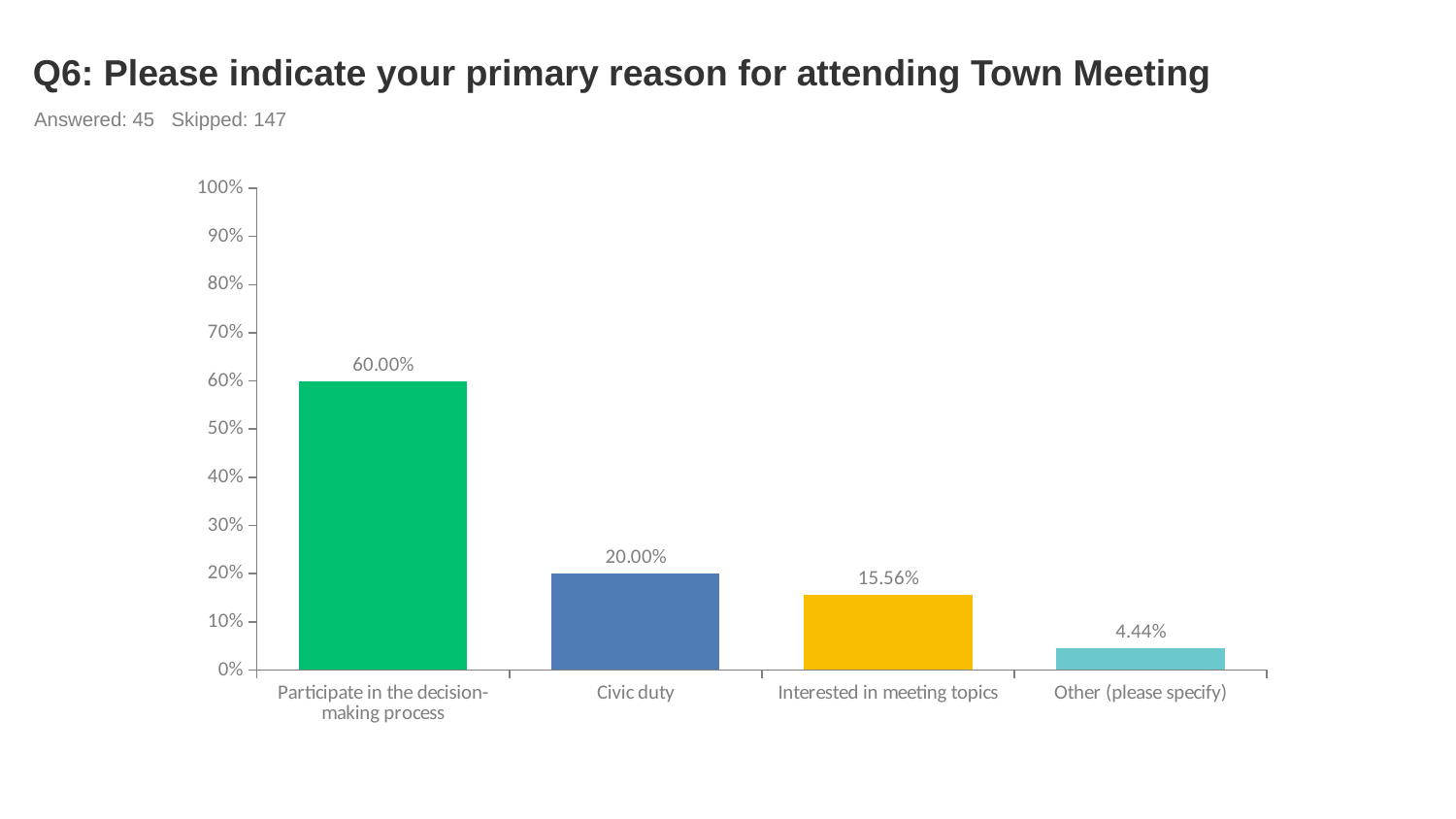
What is the value shown for 'Civic duty'? 20.00% Which is larger, the value for 'Civic duty' or the value for 'Interested in meeting topics'? Civic duty What type of chart is shown on the slide? Bar chart How many respondents answered this question, according to the slide? 45 What is the difference between 'Civic duty' and 'Interested in meeting topics'? 4.44% What percentage of respondents chose 'Participate in the decision-making process' as their primary reason for attending Town Meeting? 60.00% What is the difference in percentage points between 'Participate in the decision-making process' and 'Civic duty'? 40.00% What percentage is shown for 'Interested in meeting topics'? 15.56% Which category has the lowest percentage? Other (please specify) What is the value for 'Other (please specify)'? 4.44% How many categories are shown on the chart? 4 Which reason for attending Town Meeting has the highest percentage? Participate in the decision-making process